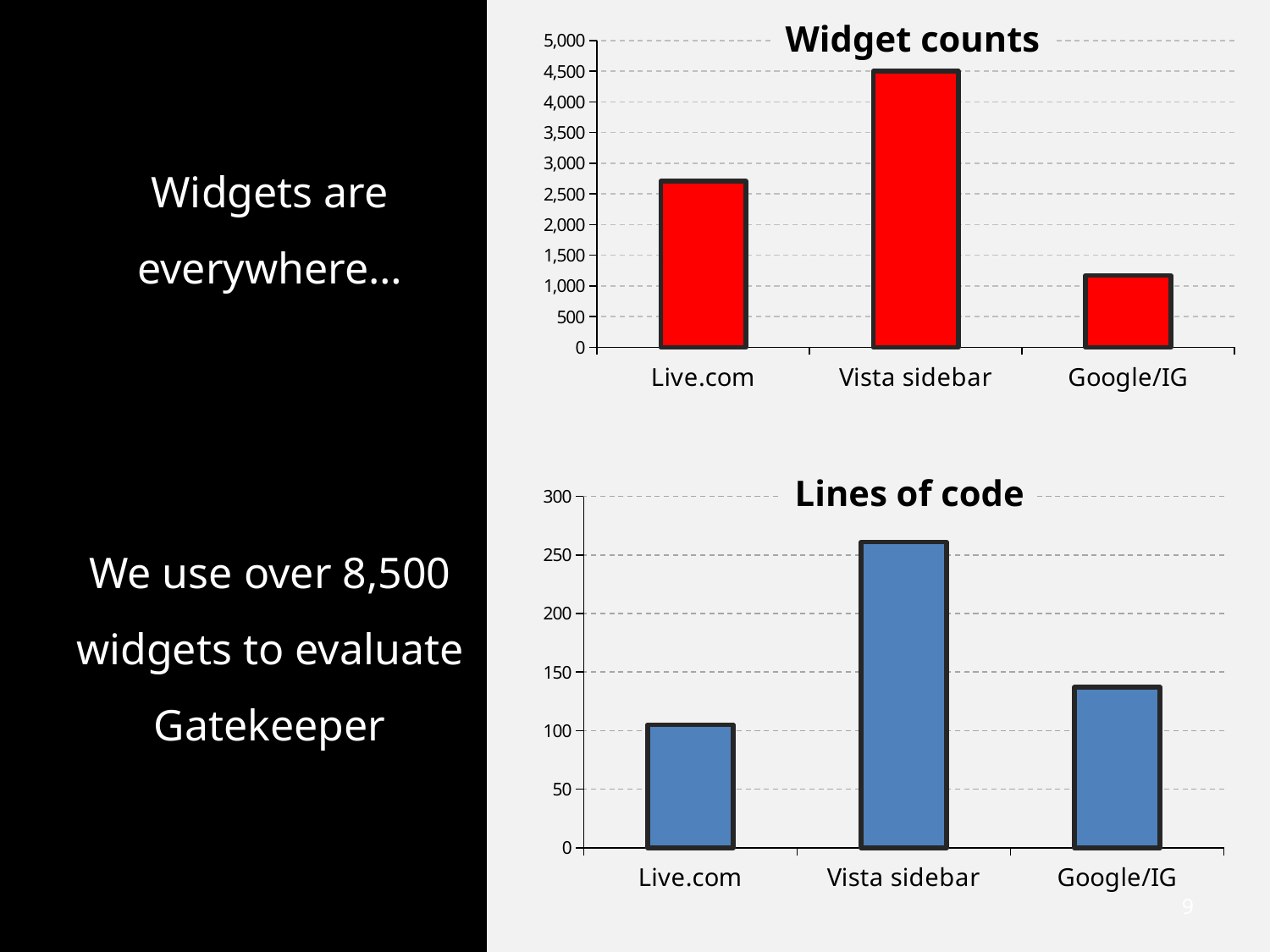
In the 'Lines of code' chart, is the value for Google/IG greater or less than 150? less In the 'Widget counts' chart, is the value for Google/IG greater or less than 1,500? less In the 'Lines of code' chart, is the value for Vista sidebar greater or less than 250? greater In the 'Widget counts' chart, which category has the highest value? Vista sidebar In the 'Lines of code' chart, which category has the lowest value? Live.com In the 'Lines of code' chart, which is larger, the value for Google/IG or the value for Live.com? Google/IG What type of chart is the 'Lines of code' chart? Bar chart In the 'Lines of code' chart, which category has the highest value? Vista sidebar How many categories are shown in the 'Widget counts' chart? 3 In the 'Widget counts' chart, which category has the lowest value? Google/IG